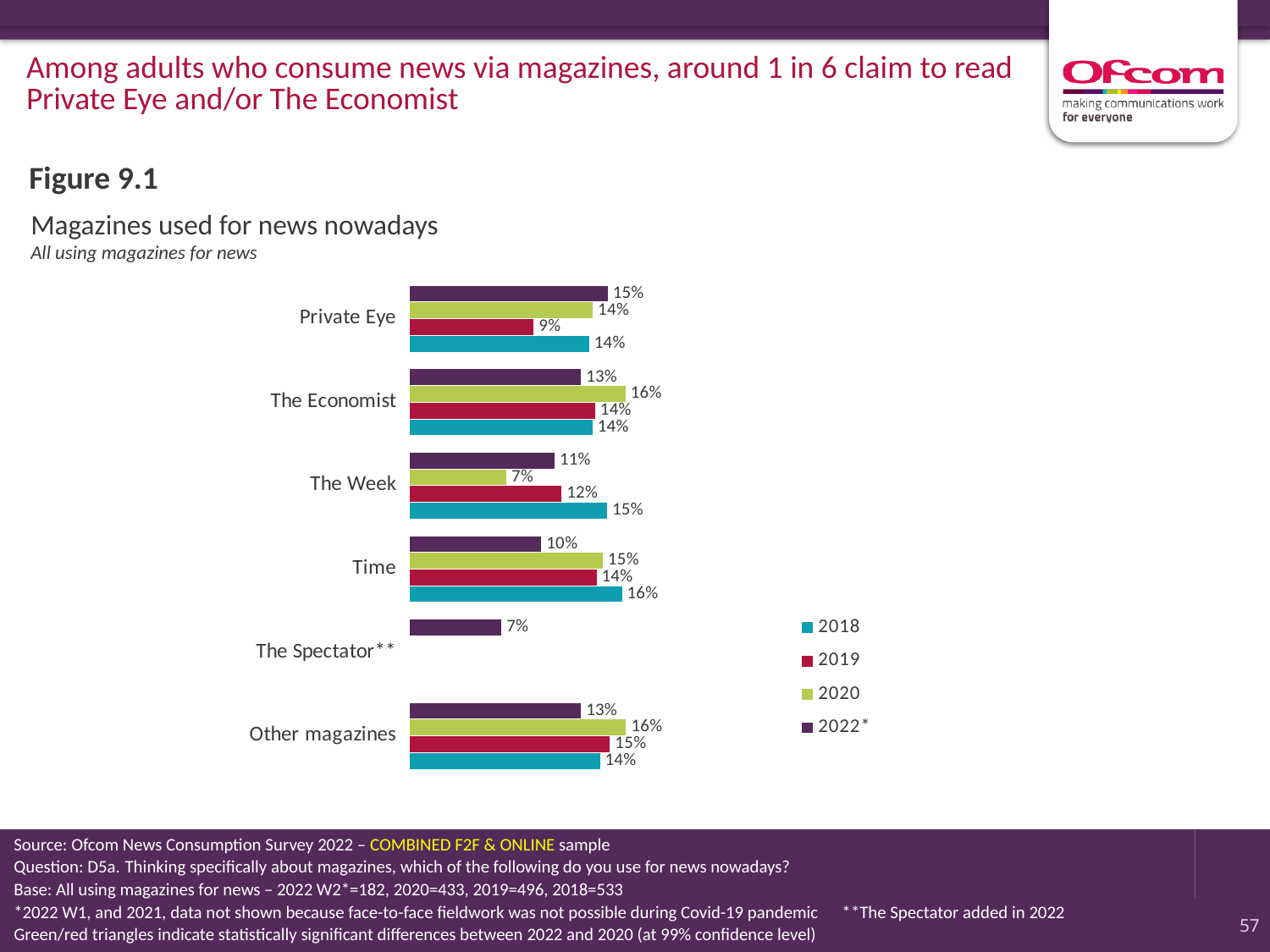
What was the value for The Week in 2020? 7% Which is larger for Time: the 2018 value or the 2022 value? 2018 What was the value for The Spectator in 2022? 7% Which year is shown in purple in the legend? 2022* What percentage of adults using magazines for news read Private Eye in 2022? 15% What was the value for The Economist in 2020? 16% Which magazine had the highest value in 2018? Time What is the difference between the 2018 and 2019 values for Private Eye? 5 percentage points How many magazine categories are shown on the chart? 6 How many series does the legend list? 4 What kind of chart is shown on the slide? Bar chart Which magazine had the lowest value in 2022? The Spectator